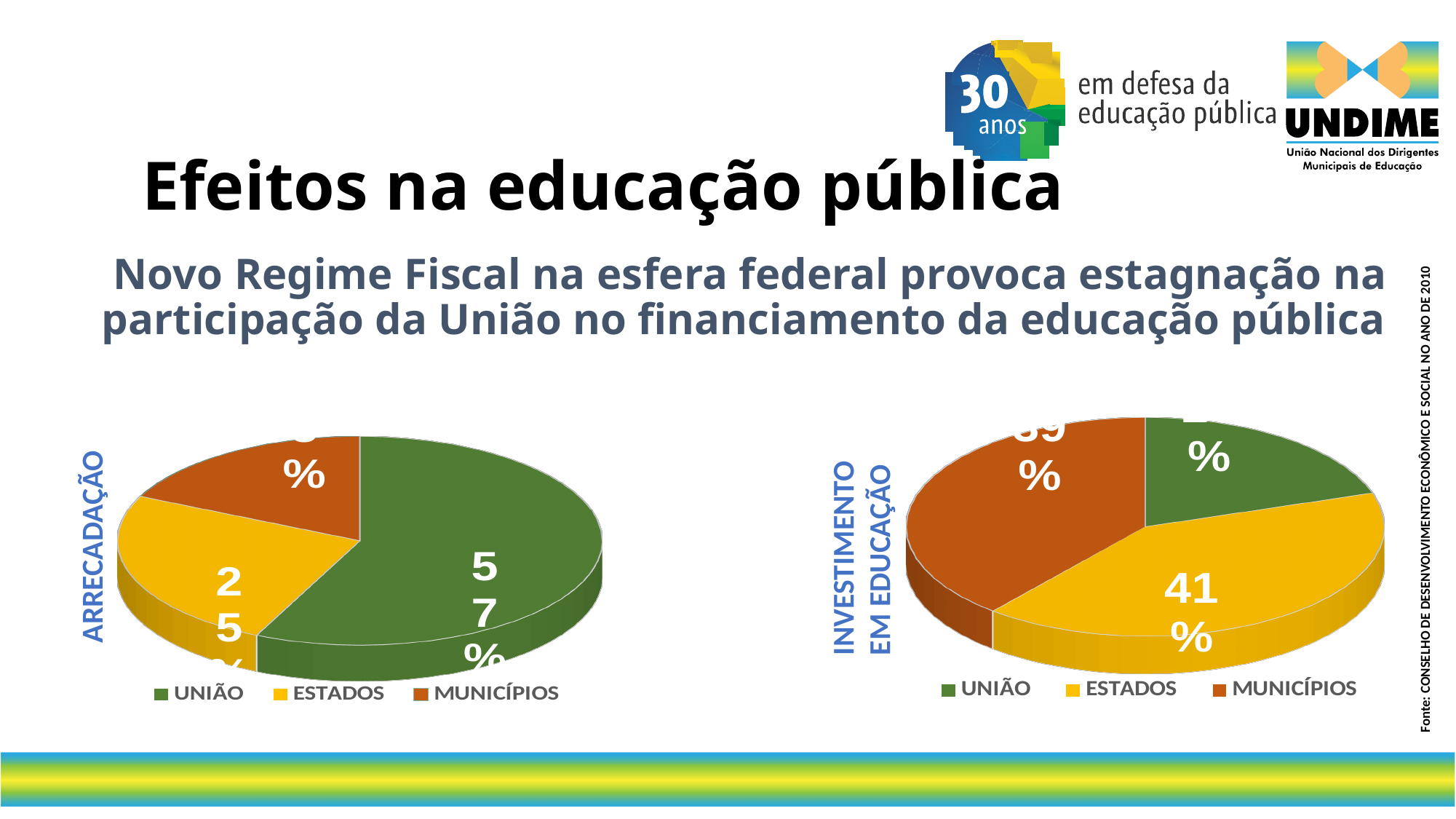
In the ARRECADAÇÃO chart, which category has the smallest slice? MUNICÍPIOS In the ARRECADAÇÃO chart, what is the share for ESTADOS? 25% In the ARRECADAÇÃO chart, which slice is larger, ESTADOS or MUNICÍPIOS? ESTADOS In the INVESTIMENTO EM EDUCAÇÃO chart, which slice is larger, UNIÃO or ESTADOS? ESTADOS In the ARRECADAÇÃO chart, which category has the largest slice? UNIÃO What kind of chart is the ARRECADAÇÃO chart on the left? Pie chart In the INVESTIMENTO EM EDUCAÇÃO chart on the right, what is the share for ESTADOS? 41% In the INVESTIMENTO EM EDUCAÇÃO chart, what colour represents UNIÃO in the legend? Green How many categories does the legend of the ARRECADAÇÃO chart list? 3 In the ARRECADAÇÃO chart, what is the share for UNIÃO? 57% In the INVESTIMENTO EM EDUCAÇÃO chart, which category has the smallest slice? UNIÃO In the ARRECADAÇÃO chart, what is the difference in percentage points between UNIÃO and ESTADOS? 32 percentage points